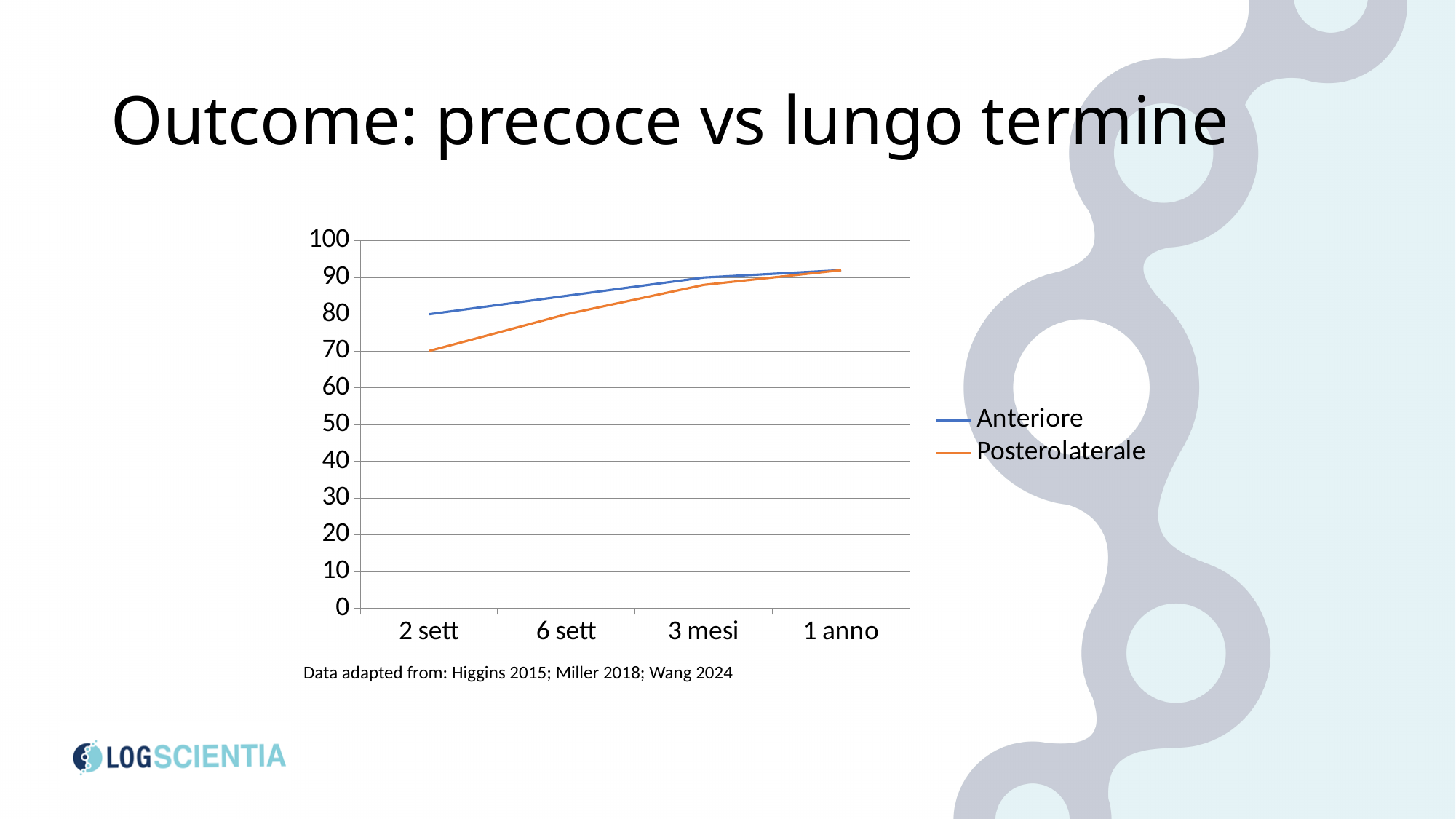
Is the value for Anteriore at 1 anno greater or less than 90? greater At 6 sett, which series has the higher value, Anteriore or Posterolaterale? Anteriore At 2 sett, which series has the higher value, Anteriore or Posterolaterale? Anteriore What kind of chart is shown on the slide? line chart How many time points are shown on the x axis? 4 How many series does the legend list? 2 What is the difference between Anteriore and Posterolaterale at 2 sett? 10 What is the value for Anteriore at 2 sett? 80 Which series is drawn in orange? Posterolaterale Is the value for Posterolaterale at 3 mesi greater or less than 80? greater What is the value for Posterolaterale at 2 sett? 70 Do the values for Posterolaterale rise or fall from 2 sett to 1 anno? rise